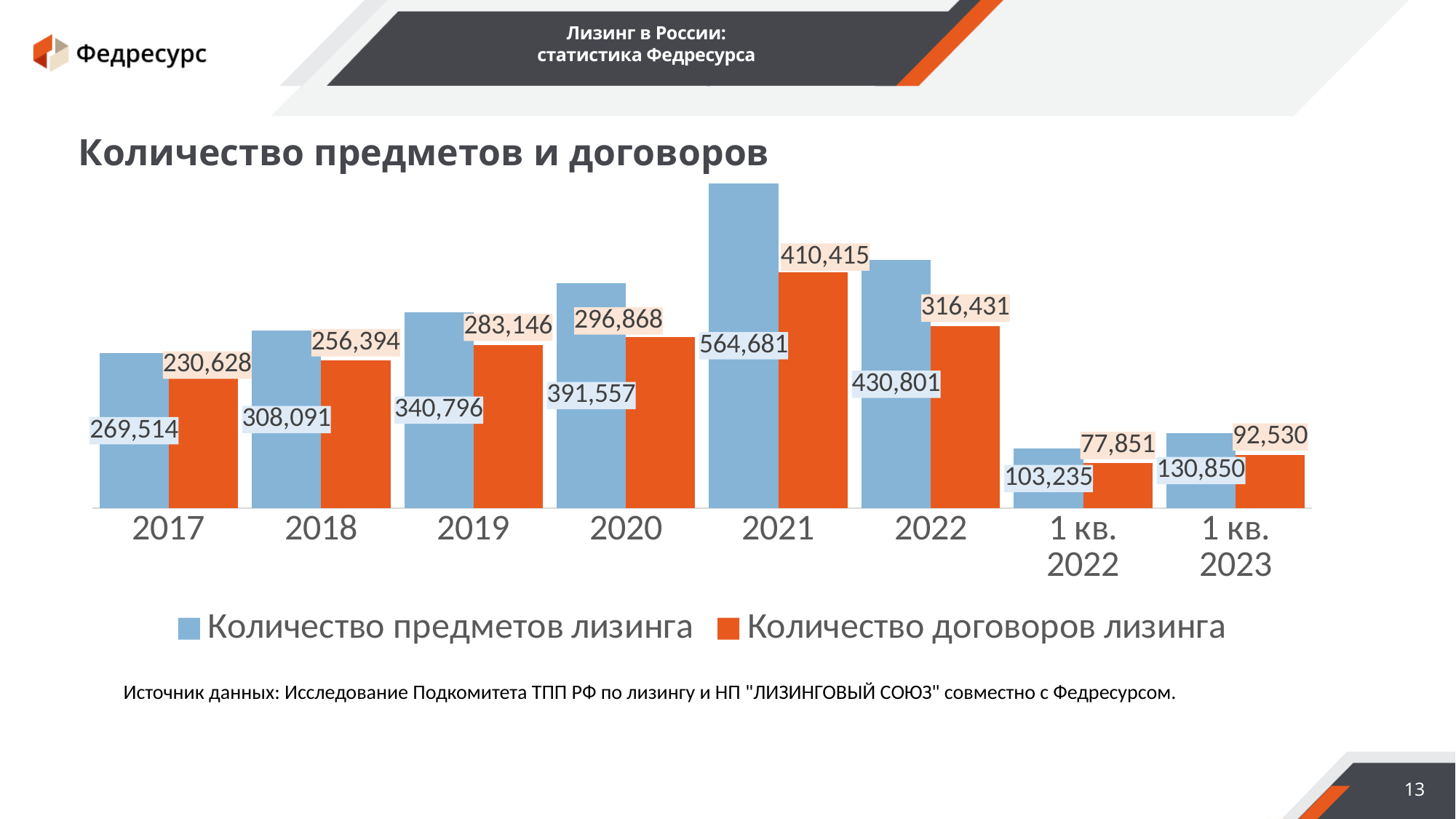
Which category has the highest value for Количество договоров лизинга? 2021 Which category has the lowest value for Количество предметов лизинга? 1 кв. 2022 What type of chart is shown on the slide? Bar chart How many categories are shown on the x axis? 8 What is the value of Количество договоров лизинга for 2019? 283,146 Which is larger: Количество предметов лизинга in 2022 or in 2020? 2022 How many series does the legend list? 2 By how much did Количество предметов лизинга in 1 кв. 2023 exceed that in 1 кв. 2022? 27,615 What is the value of Количество предметов лизинга for 1 кв. 2023? 130,850 What is the value of Количество договоров лизинга for 1 кв. 2022? 77,851 What is the value of Количество предметов лизинга for 2021? 564,681 What is the difference between Количество предметов лизинга and Количество договоров лизинга in 2021? 154,266